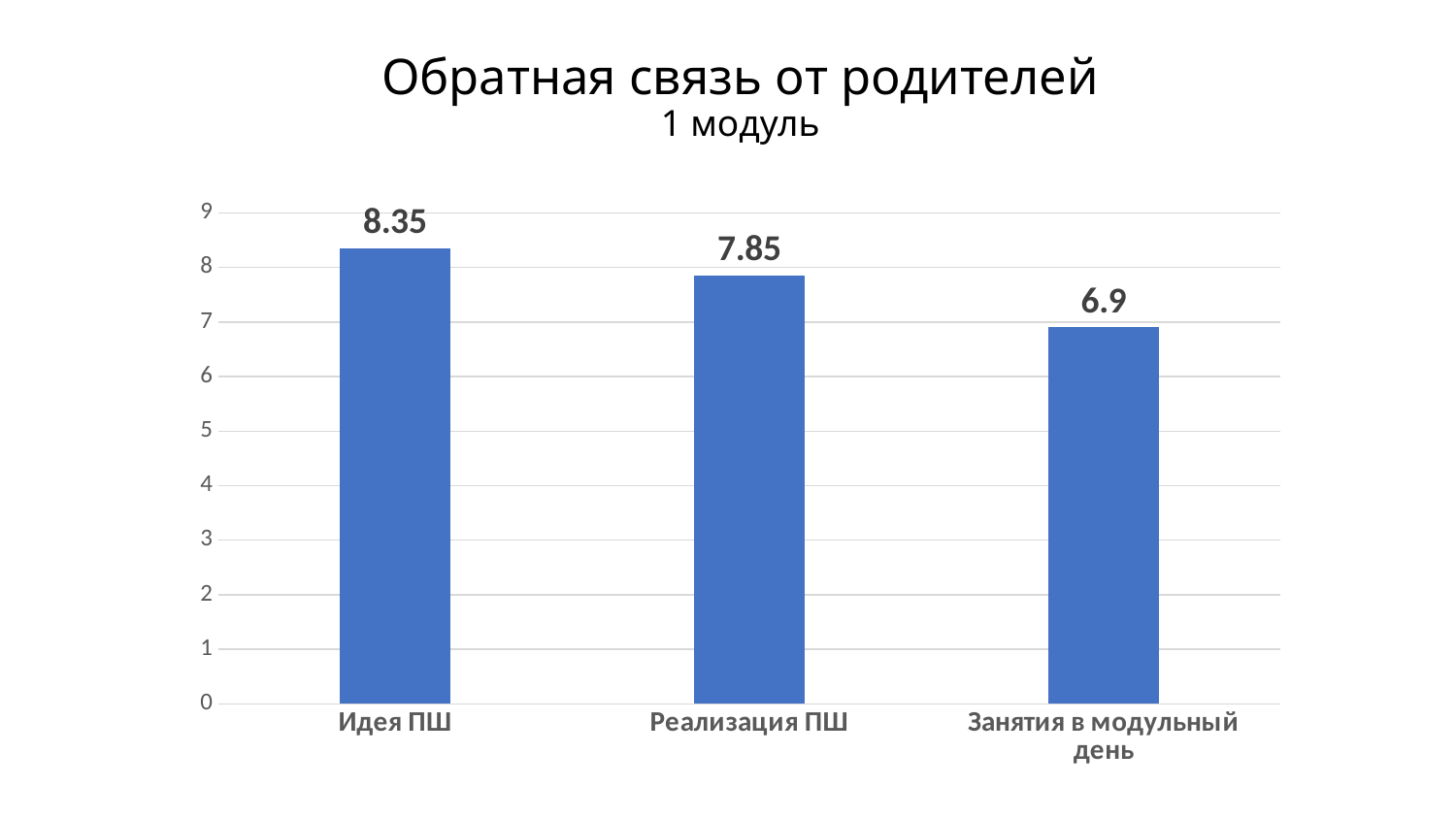
What is the value for Идея ПШ? 8.35 Which category has the lowest value? Занятия в модульный день Do the values rise or fall from left to right across the categories? fall Which category has the highest value? Идея ПШ What is the difference between the values for Реализация ПШ and Занятия в модульный день? 0.95 What is the difference between the values for Идея ПШ and Реализация ПШ? 0.5 Is the value for Занятия в модульный день greater or less than 7? less What is the value for Реализация ПШ? 7.85 What kind of chart is shown on the slide? bar chart How many categories are shown in the chart? 3 What is the value for Занятия в модульный день? 6.9 Which is larger, the value for Идея ПШ or the value for Занятия в модульный день? Идея ПШ